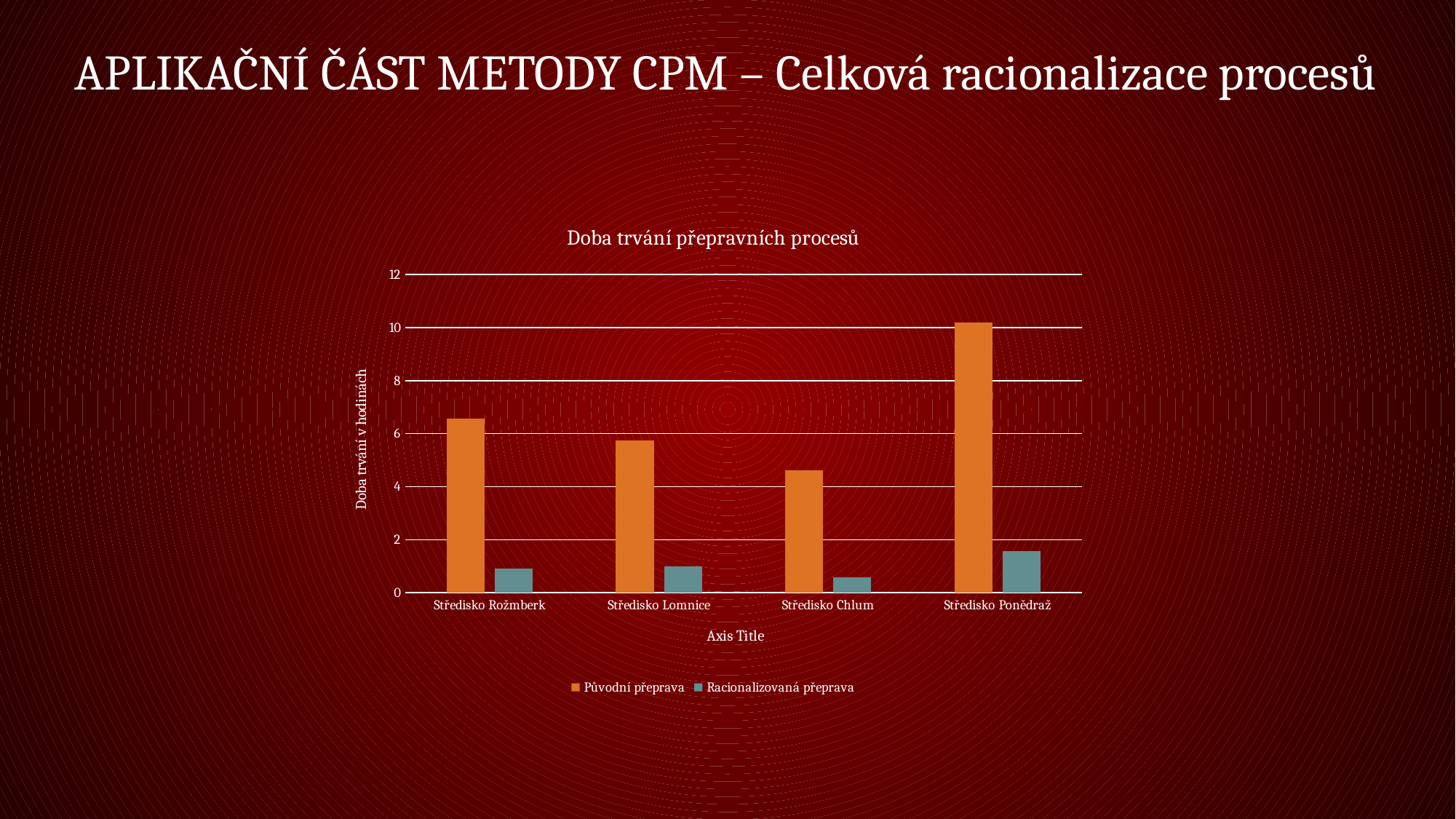
What kind of chart is shown on the slide? bar chart Which středisko has the highest value for Původní přeprava? Středisko Ponědraž Which středisko has the lowest value for Původní přeprava? Středisko Chlum Is the value for Původní přeprava at Středisko Rožmberk greater or less than 6? greater What is the label of the vertical axis? Doba trvání v hodinách Is the value for Racionalizovaná přeprava at Středisko Ponědraž greater or less than 2? less Is the value for Původní přeprava at Středisko Ponědraž greater or less than 10? greater What is the title of the chart? Doba trvání přepravních procesů How many series does the legend list? 2 Which is larger at Středisko Lomnice: Původní přeprava or Racionalizovaná přeprava? Původní přeprava Which středisko has the lowest value for Racionalizovaná přeprava? Středisko Chlum How many categories (střediska) are shown on the x axis? 4